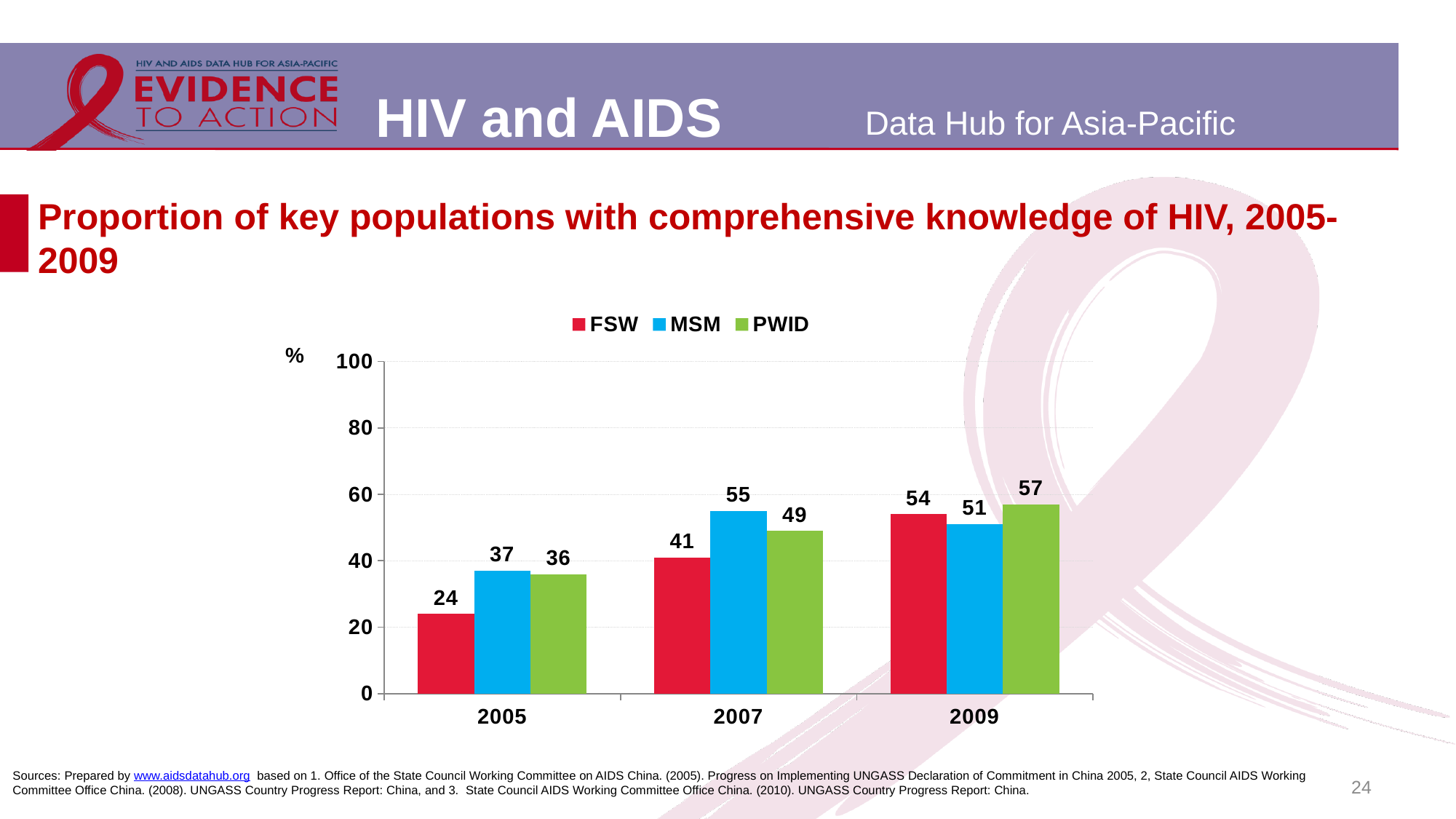
Which series has the lowest value in 2005? FSW What is the value for PWID in 2009? 57 What is the difference between the FSW values in 2009 and 2005? 30 Which is larger, the MSM value in 2007 or the PWID value in 2007? MSM value in 2007 Which series has the highest value in 2009? PWID Is the value for FSW in 2007 greater or less than 40? greater Does the FSW value rise or fall from 2005 to 2009? Rise What is the value for MSM in 2007? 55 What is the value for FSW in 2005? 24 How many years are shown on the x axis? 3 How many series does the legend list? 3 What kind of chart is shown on the slide? Bar chart